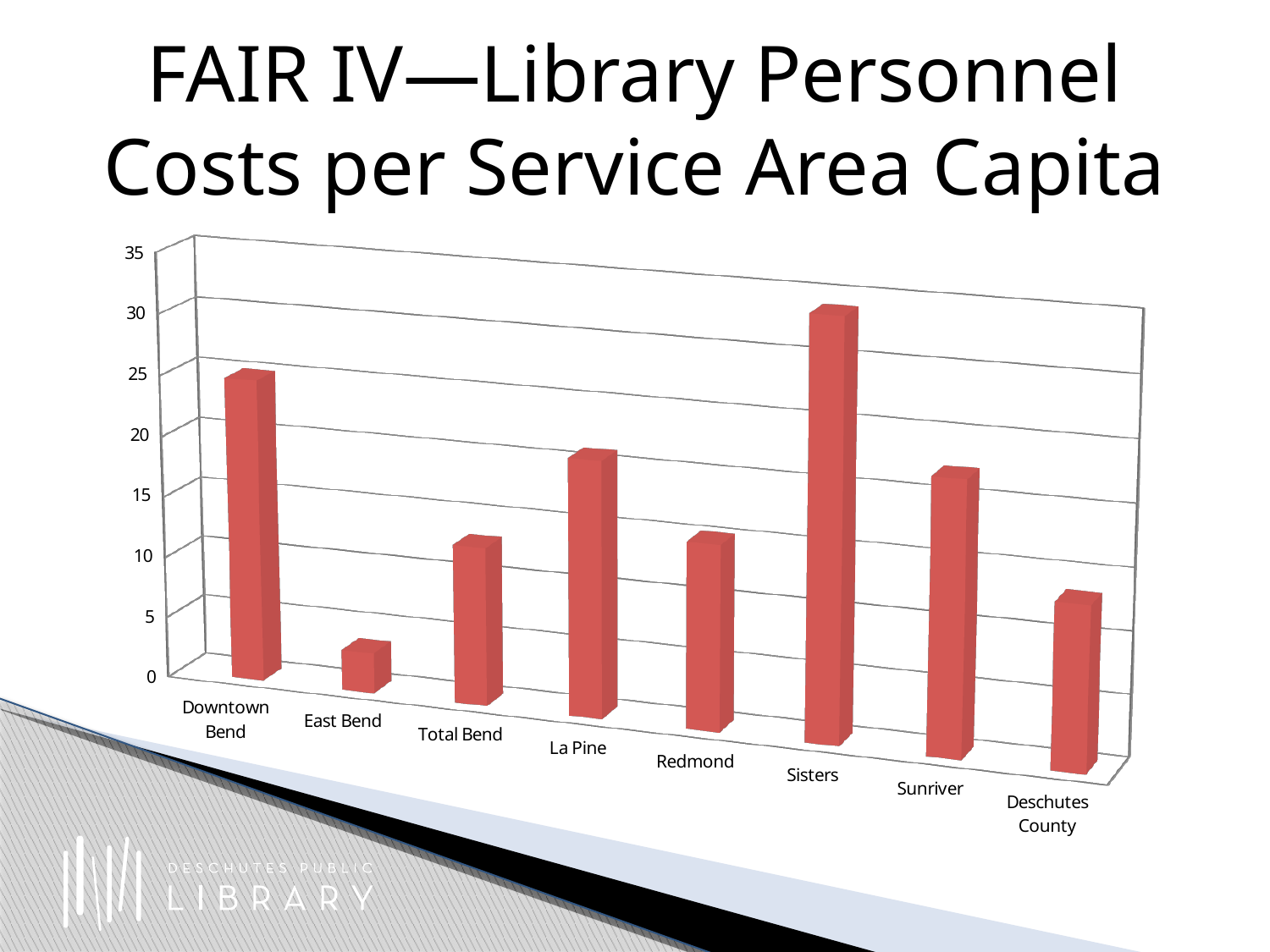
Is the value for Sunriver greater or less than 10? greater Which category has the lowest library personnel cost per service area capita? East Bend Is the value for Sisters greater or less than 25? greater What kind of chart is shown on the slide? bar chart What is the title of the slide containing the chart? FAIR IV—Library Personnel Costs per Service Area Capita How many categories are plotted on the chart? 8 Which category has the highest library personnel cost per service area capita? Sisters Which is larger, the value for Downtown Bend or the value for La Pine? Downtown Bend Is the value for Downtown Bend greater or less than 20? greater